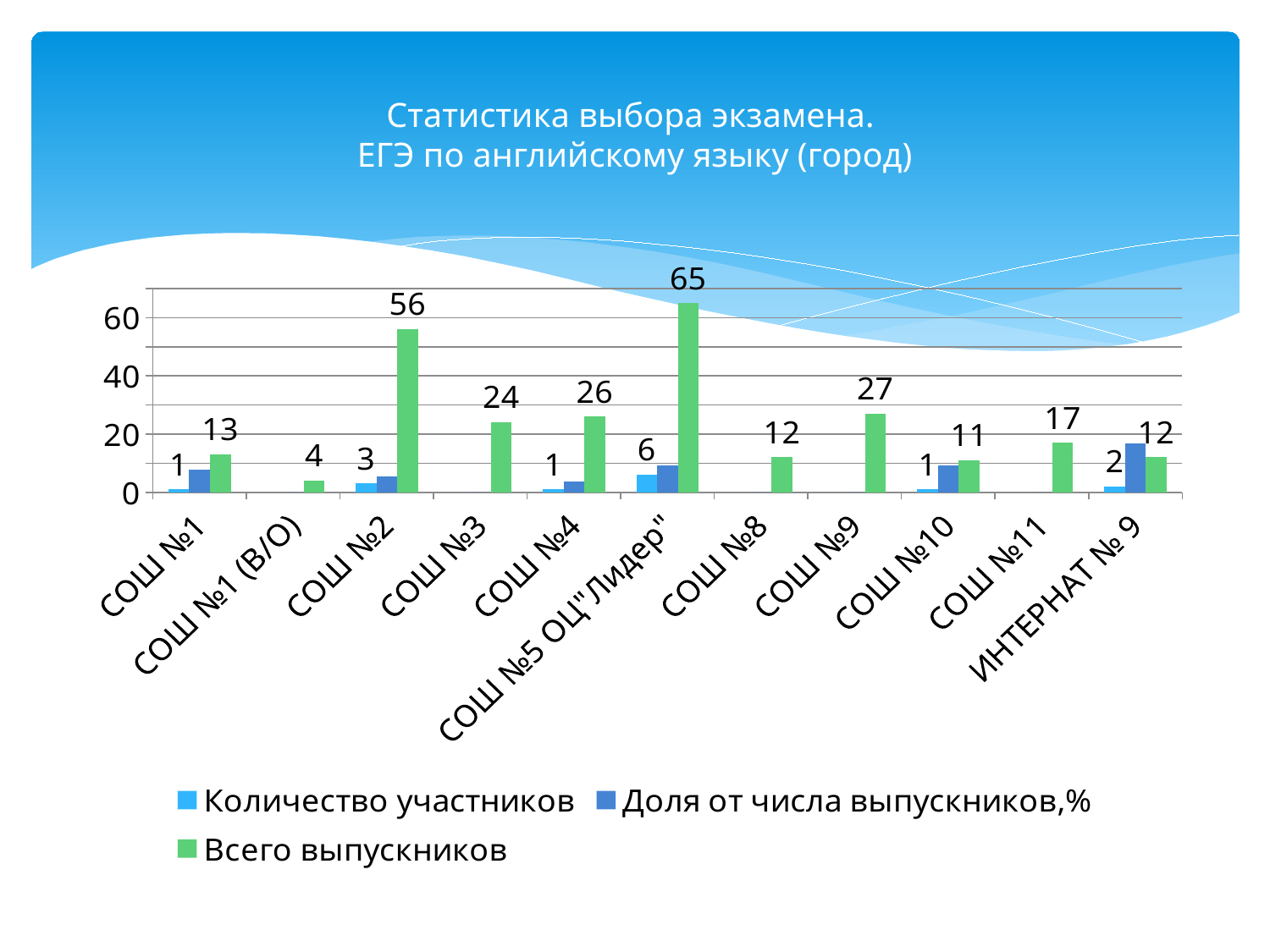
Is the value of Доля от числа выпускников,% for ИНТЕРНАТ № 9 greater or less than 20? less Which school has the highest value for Всего выпускников? СОШ №5 ОЦ"Лидер" What is the value of Количество участников for СОШ №5 ОЦ"Лидер"? 6 How many schools (categories) are shown on the x axis? 11 How many series does the legend list? 3 What is the value of Всего выпускников for СОШ №11? 17 Which school has the lowest value for Всего выпускников? СОШ №1 (В/О) What is the difference in Всего выпускников between СОШ №5 ОЦ"Лидер" and СОШ №2? 9 Which has a larger value for Всего выпускников, СОШ №3 or СОШ №9? СОШ №9 What is the value of Всего выпускников for СОШ №2? 56 What is the title of the chart? Статистика выбора экзамена. ЕГЭ по английскому языку (город) What kind of chart is shown on the slide? bar chart